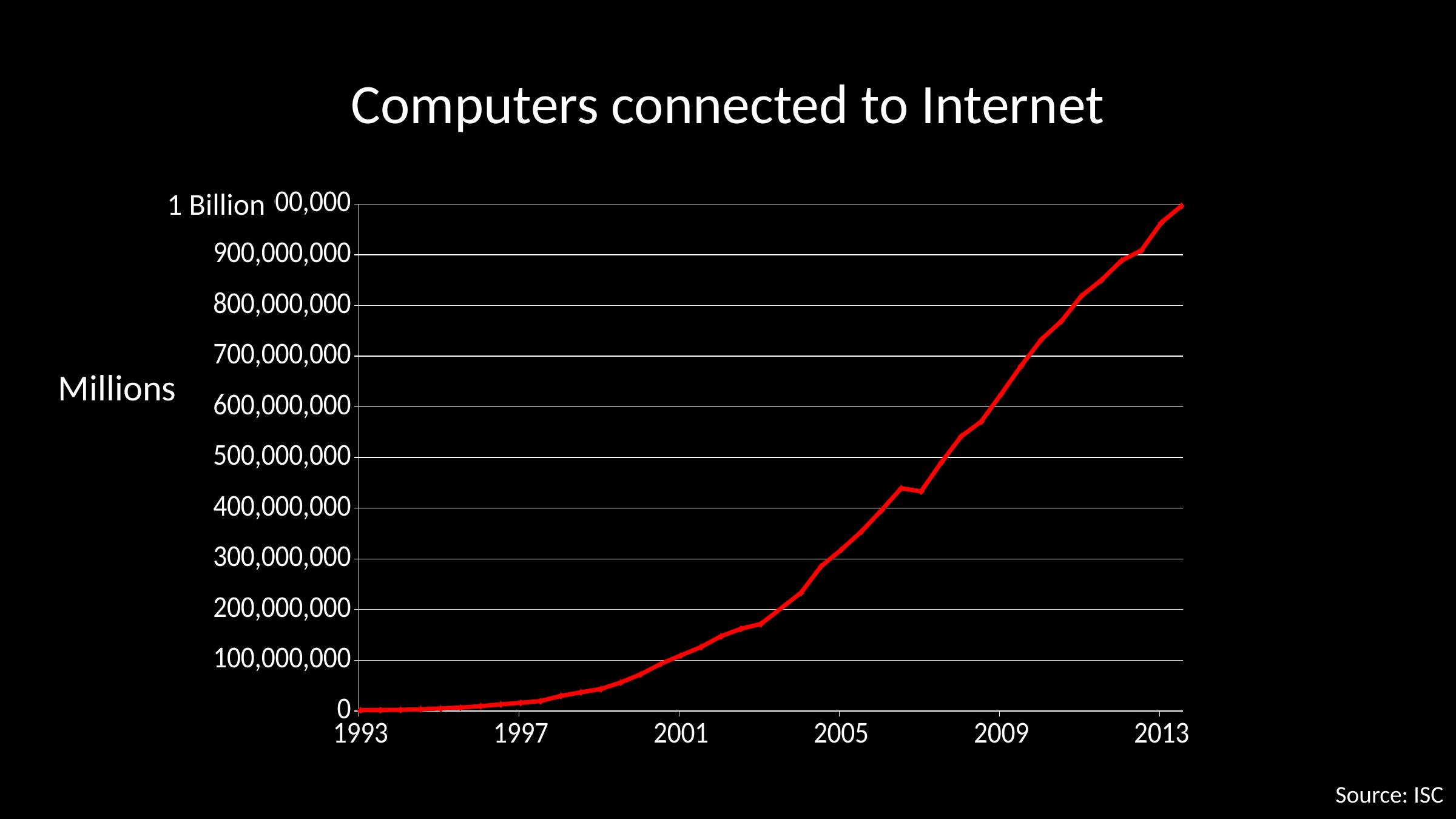
What kind of chart is shown on the slide? line chart What source is cited for the chart? ISC Do the values rise or fall from 1993 to 2013? rise What is the title of the chart? Computers connected to Internet Is the value for 2013 greater or less than 800,000,000? greater Which is larger, the value for 2009 or the value for 2005? 2009 Is the value for 1997 greater or less than 100,000,000? less Which year shown on the x axis has the highest value? 2013 Is the value for 2009 greater or less than 500,000,000? greater What is the highest tick value shown on the y axis? 1 Billion Which year shown on the x axis has the lowest value? 1993